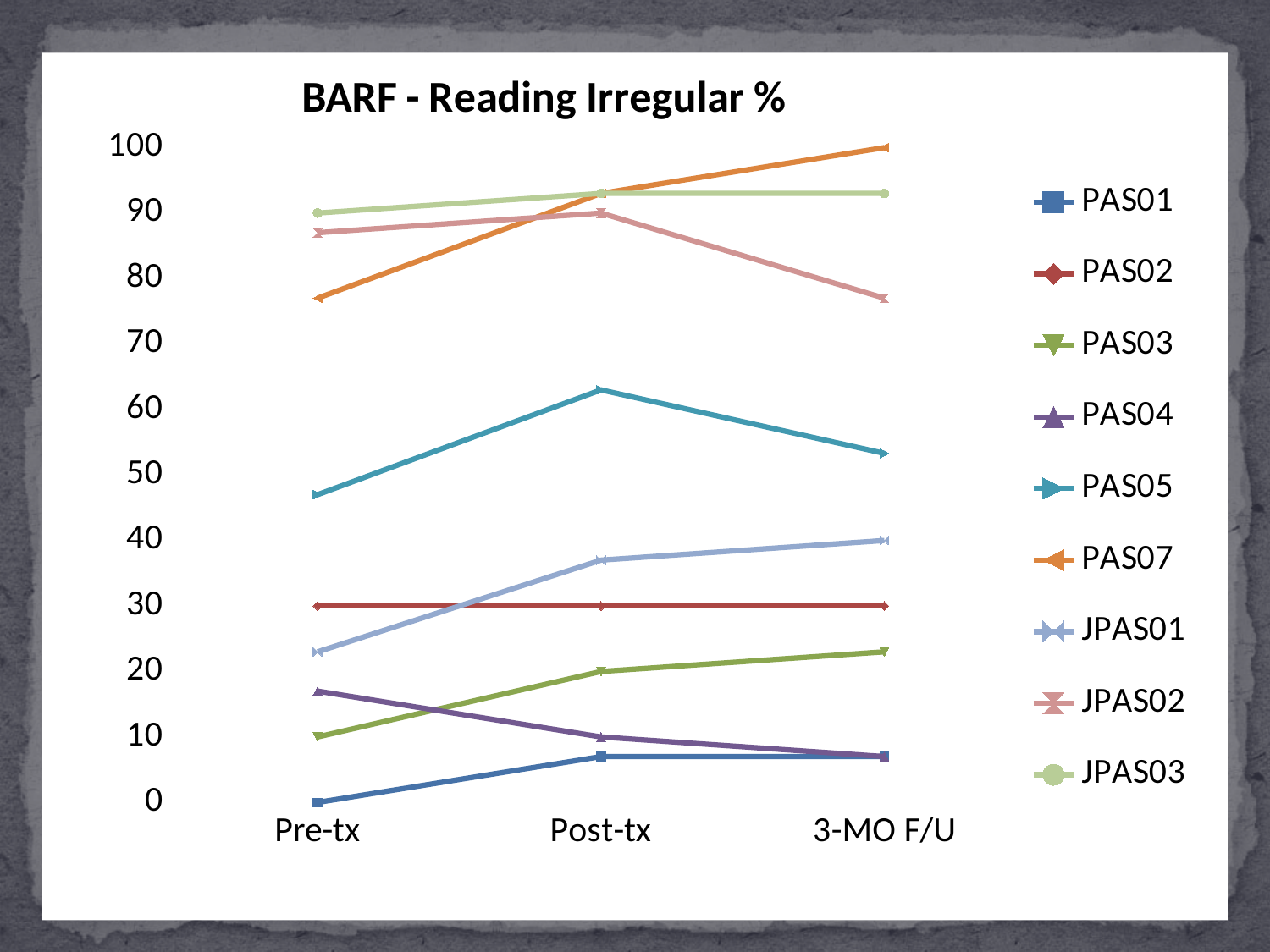
What is the value for PAS02 at Post-tx? 30 Which series has the lowest value at Pre-tx? PAS01 What kind of chart is shown on the slide? line chart Does the PAS07 line rise or fall from Pre-tx to 3-MO F/U? rise How many series does the legend list? 9 At 3-MO F/U, which is larger, JPAS02 or JPAS03? JPAS03 What is the value for PAS07 at 3-MO F/U? 100 Which series has the highest value at 3-MO F/U? PAS07 How many time points are shown on the x axis? 3 Is the value for PAS05 at Post-tx greater or less than 60? greater What is the value for PAS01 at Pre-tx? 0 Does the PAS04 line rise or fall from Pre-tx to 3-MO F/U? fall